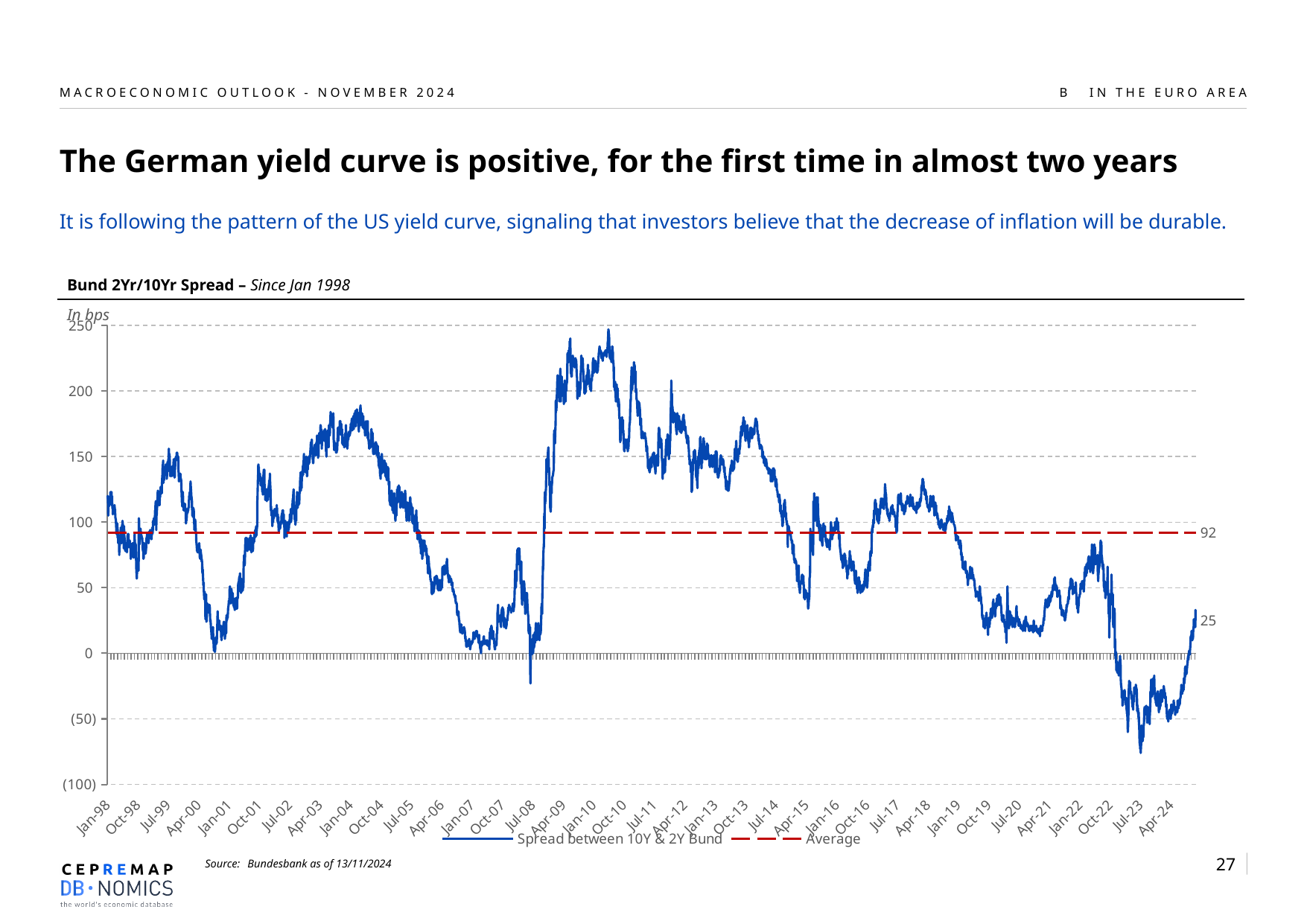
What is the latest value of the spread between 10Y & 2Y Bund labelled at the right end of the line? 25 What is the difference between the average (92) and the latest spread value (25)? 67 In what unit are the values on the chart expressed? bps Does the spread rise or fall between Jul-23 and the end of the series? rise What is the value of the Average line shown on the chart? 92 What is the title of the chart? Bund 2Yr/10Yr Spread – Since Jan 1998 Is the spread around Jan-01 greater or less than 50? less Is the spread around Jan-04 greater or less than 150? greater How many series does the legend list? 2 What kind of chart is shown on the slide? line chart Which is larger, the latest spread value or the average? Average Is the spread around Jul-23 greater or less than 0? less